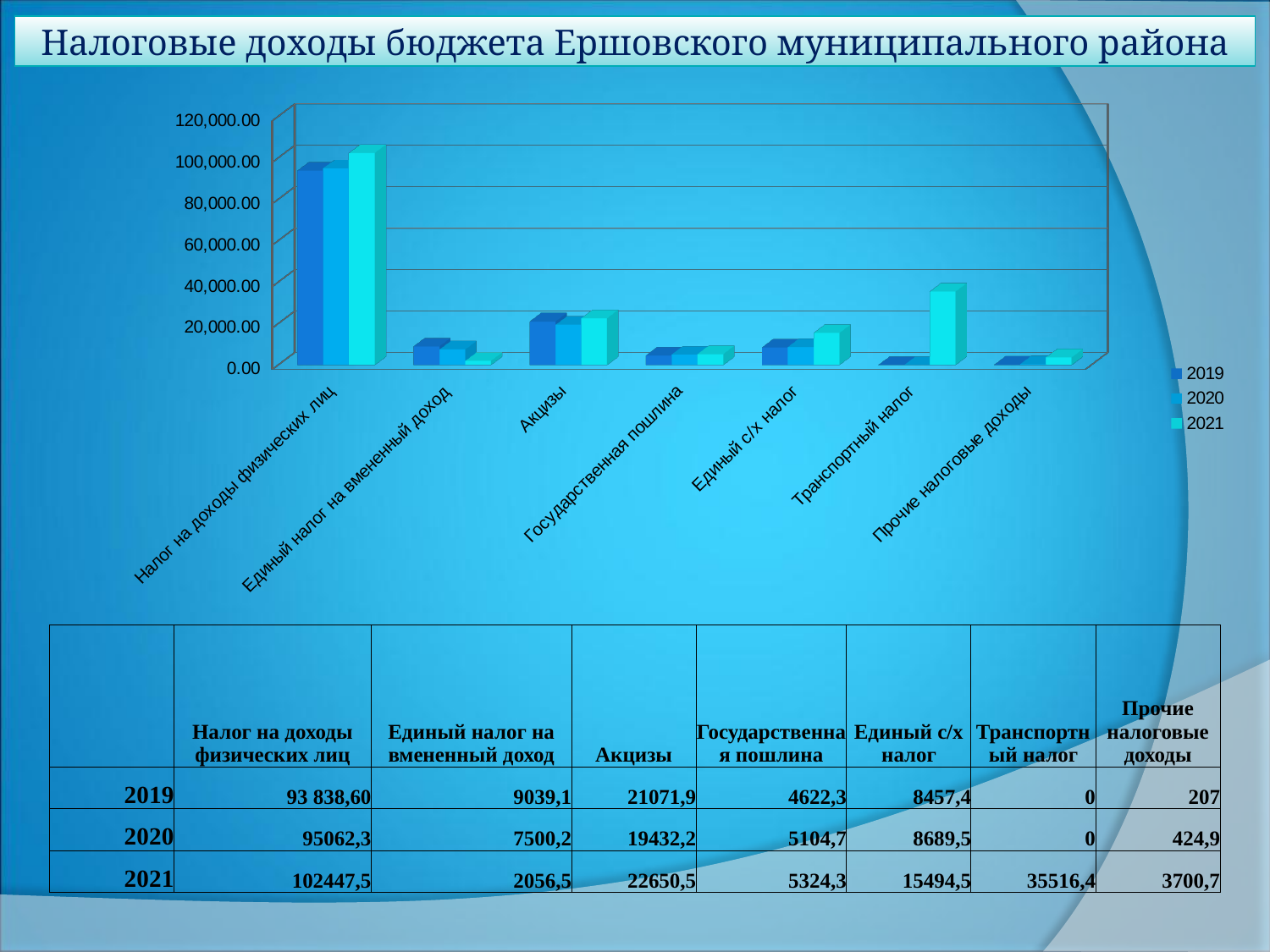
Which category has the highest value for 2019? Налог на доходы физических лиц How many series does the chart legend list? 3 What is the difference between the 2021 and 2020 values for Единый с/х налог? 6805 How many categories are plotted along the x axis of the chart? 7 Which category has the lowest value for 2020? Транспортный налог Is the 2021 value for Транспортный налог greater or less than 20,000.00? greater What is the value of Транспортный налог for 2021? 35516,4 Which is larger: the 2019 value for Акцизы or the 2019 value for Единый налог на вмененный доход? Акцизы What is the value of Налог на доходы физических лиц for 2021? 102447,5 Do the values for Единый налог на вмененный доход rise or fall from 2019 to 2021? fall What kind of chart is shown on the slide? bar chart What is the value of Акцизы for 2020? 19432,2